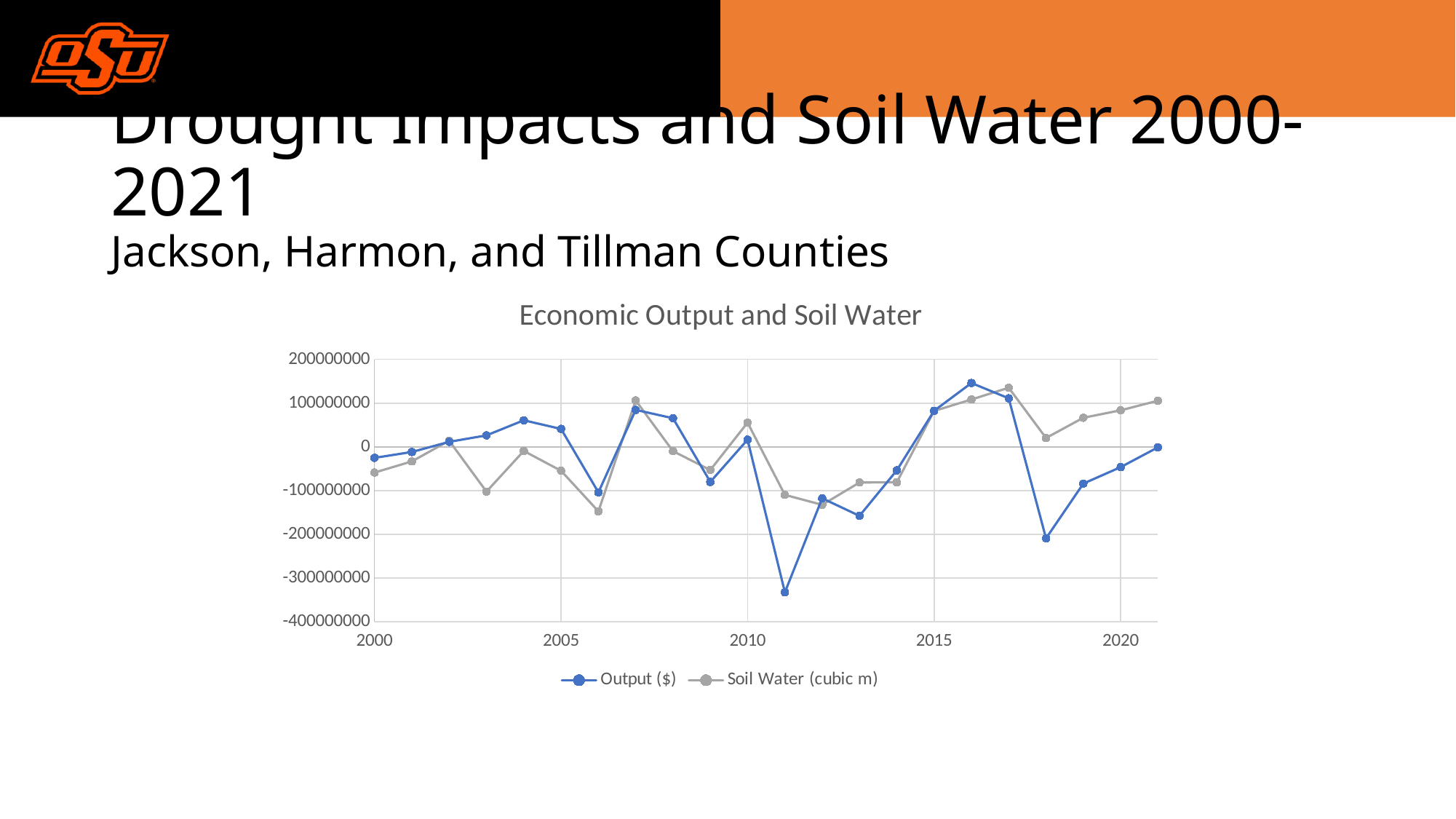
In which year is the Output ($) series at its highest? 2016 In which year is the Soil Water (cubic m) series at its highest? 2017 In which year is the Output ($) series at its lowest? 2011 Is the value for Soil Water (cubic m) in 2006 greater or less than -100000000? less Is the value for Output ($) in 2011 greater or less than -300000000? less Which series is drawn in blue? Output ($) Is the value for Output ($) in 2016 greater or less than 100000000? greater How many series does the legend list? 2 What kind of chart is shown on the slide? line chart What is the title of the chart? Economic Output and Soil Water Does the Output ($) series rise or fall from 2018 to 2021? rise In 2018, which series has the larger value, Output ($) or Soil Water (cubic m)? Soil Water (cubic m)